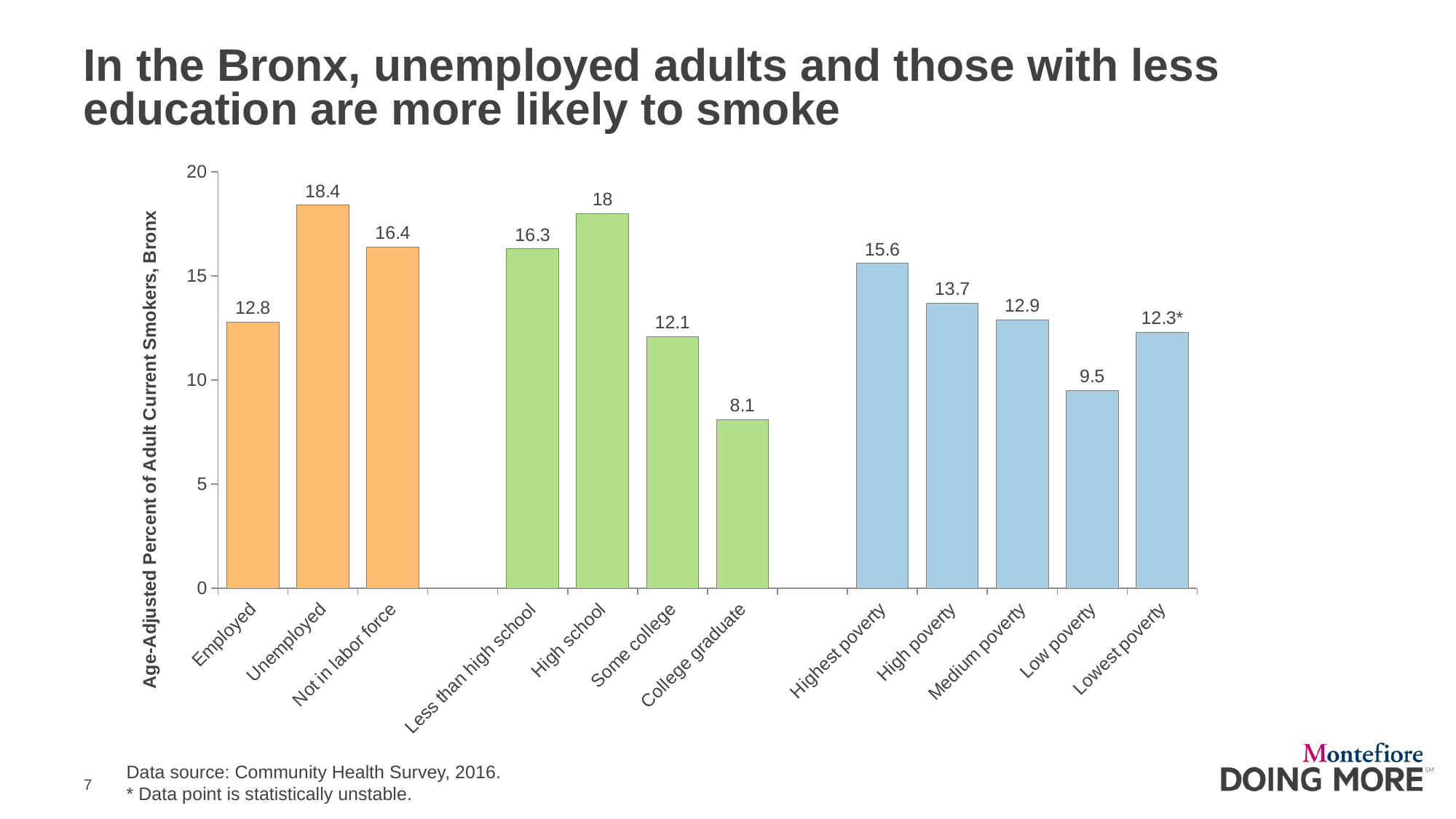
Is the value for Not in labor force greater or less than 15? greater Which data point is marked with an asterisk as statistically unstable? Lowest poverty Which category has the highest value on the chart? Unemployed What is the value shown for Low poverty? 9.5 How many categories (bars) are shown on the chart? 12 What kind of chart is shown on the slide? Bar chart Which category has the lowest value on the chart? College graduate What is the difference between the values for Unemployed and Employed? 5.6 What is the difference between the values for High school and Some college? 5.9 What is the value shown for College graduate? 8.1 Which is larger, the value for Highest poverty or the value for Medium poverty? Highest poverty What is the age-adjusted percent of adult current smokers for Unemployed adults in the Bronx? 18.4